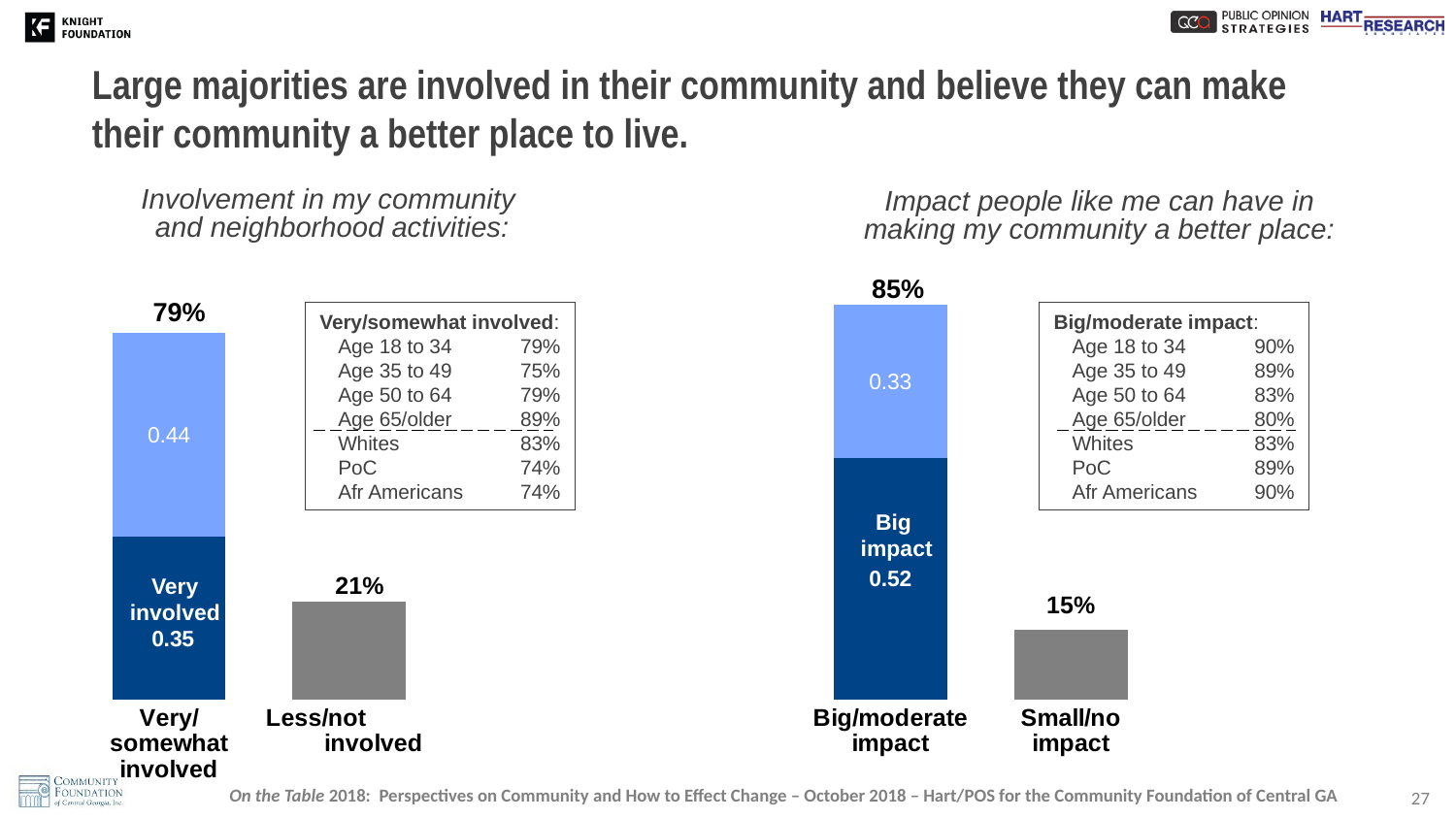
In the 'Impact people like me can have in making my community a better place' chart, what is the difference between the big/moderate impact and small/no impact percentages? 70% What kind of chart is used on the left side of the slide for involvement in community activities? Bar chart In the 'Impact people like me can have in making my community a better place' chart, what percentage of Afr Americans say big/moderate impact? 90% In the 'Impact people like me can have in making my community a better place' chart, what percentage say small/no impact? 15% In the 'Impact people like me can have in making my community a better place' chart, what percentage say big/moderate impact? 85% In the 'Involvement in my community and neighborhood activities' chart, what is the difference between the very/somewhat involved and less/not involved percentages? 58% In the 'Impact people like me can have in making my community a better place' chart, what value is shown for the 'Big impact' segment? 0.52 In the 'Involvement in my community and neighborhood activities' chart, what percentage are very/somewhat involved? 79% In the 'Involvement in my community and neighborhood activities' chart, what value is shown for the 'Very involved' segment of the stacked bar? 0.35 In the 'Involvement in my community and neighborhood activities' chart, what percentage of those age 65/older are very/somewhat involved? 89% In the 'Impact people like me can have in making my community a better place' chart, which category is higher: big/moderate impact or small/no impact? Big/moderate impact In the 'Involvement in my community and neighborhood activities' chart, what percentage are less/not involved? 21%